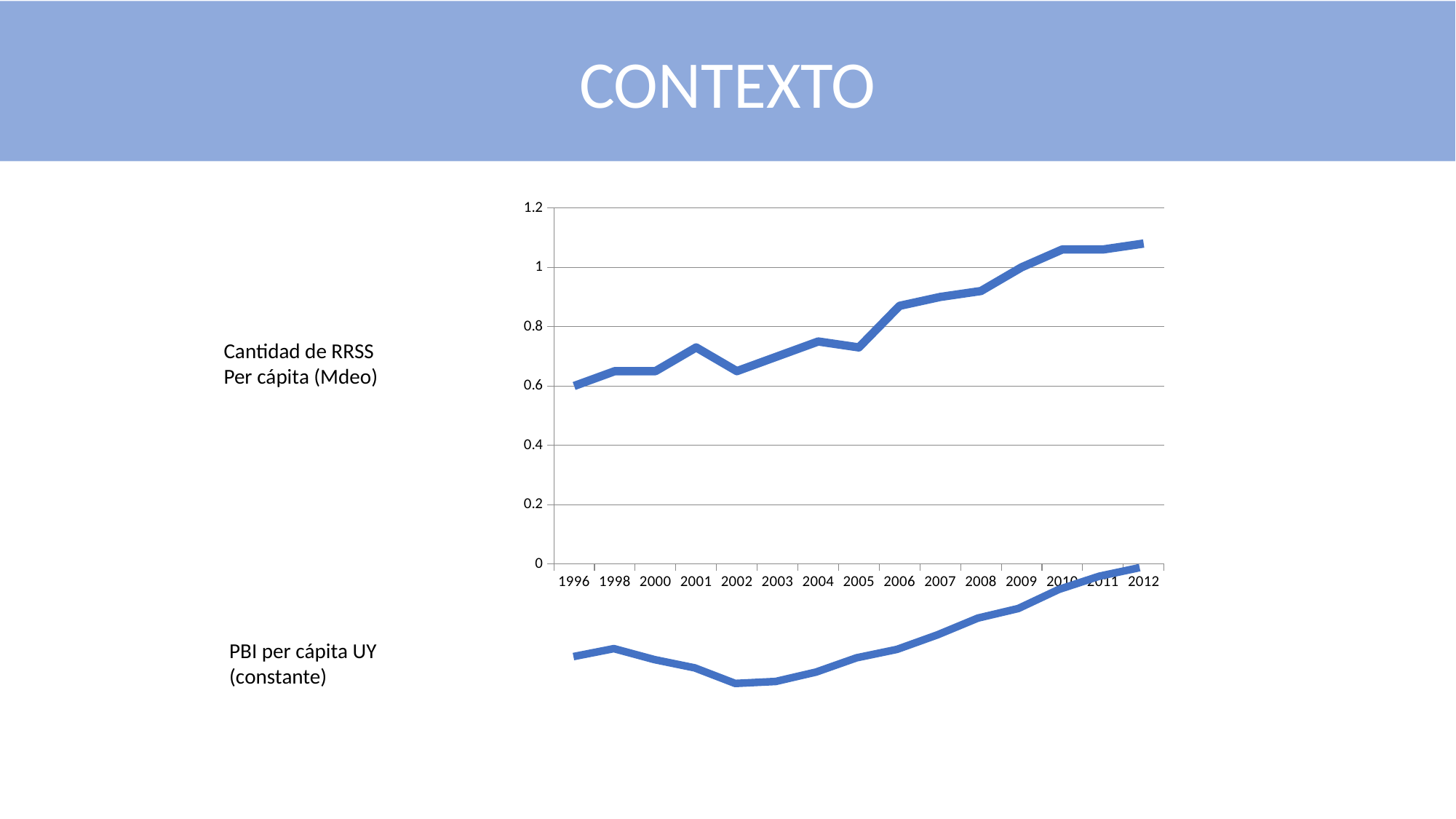
In the 'Cantidad de RRSS Per cápita (Mdeo)' chart, is the value for 2006 greater or less than 0.8? greater What kind of chart is used for 'Cantidad de RRSS Per cápita (Mdeo)'? line chart What is the highest tick value shown on the y axis of the 'Cantidad de RRSS Per cápita (Mdeo)' chart? 1.2 In the 'Cantidad de RRSS Per cápita (Mdeo)' chart, is the value for 2008 greater or less than 1? less In the 'Cantidad de RRSS Per cápita (Mdeo)' chart, which is larger, the value for 2001 or the value for 2002? 2001 How many years are labelled on the x axis of the 'Cantidad de RRSS Per cápita (Mdeo)' chart? 15 In the 'Cantidad de RRSS Per cápita (Mdeo)' chart, is the value for 2012 greater or less than 1? greater In the 'Cantidad de RRSS Per cápita (Mdeo)' chart, which is larger, the value for 2005 or the value for 2006? 2006 In the 'Cantidad de RRSS Per cápita (Mdeo)' chart, which year has the lowest value? 1996 In the 'Cantidad de RRSS Per cápita (Mdeo)' chart, do the values generally rise or fall from 1996 to 2012? rise